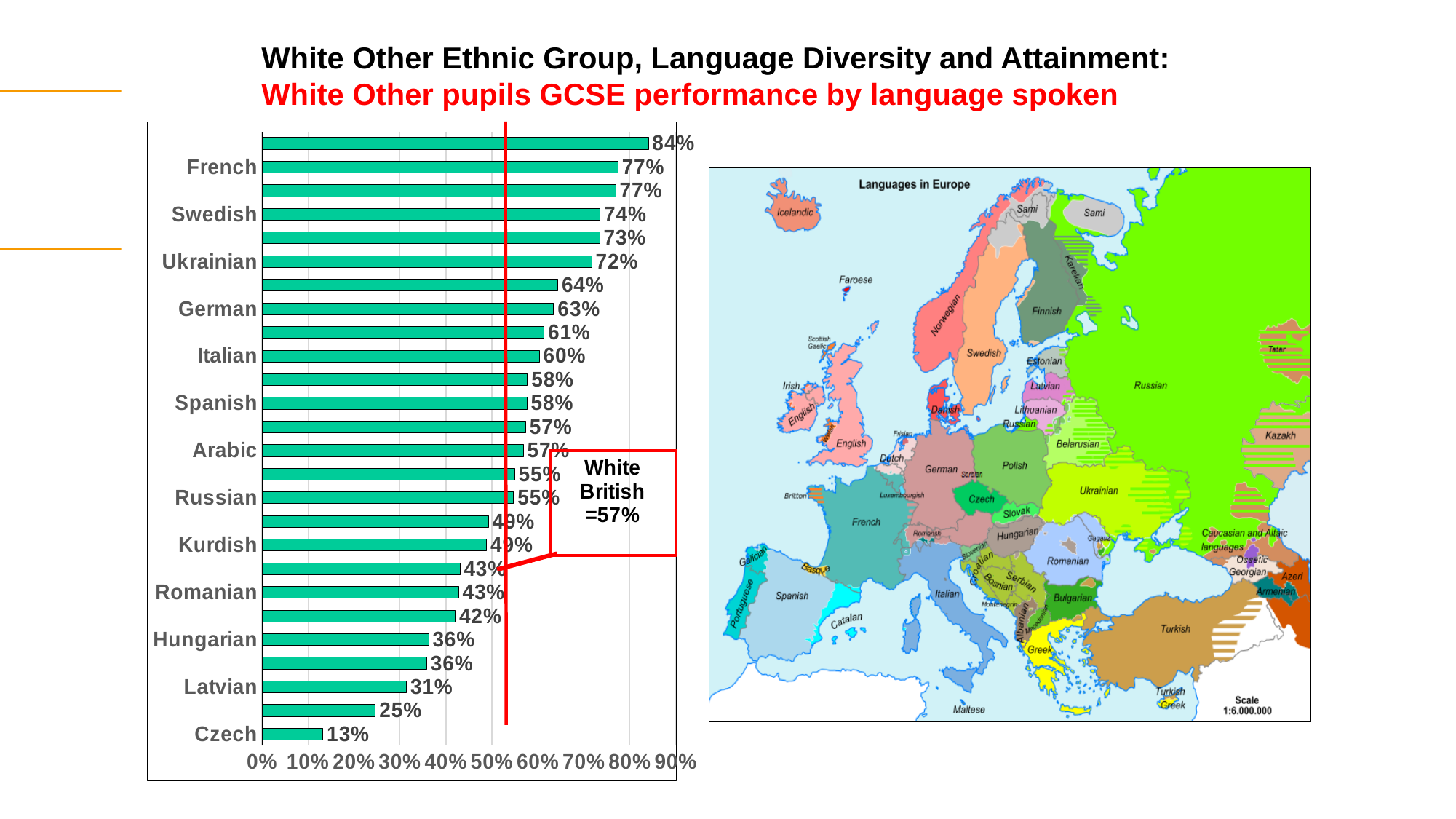
What is the difference between the values for Swedish and Latvian speakers? 43 percentage points What is the value shown for German-speaking pupils? 63% Is the value for Ukrainian speakers greater or less than 70%? greater Which has the higher value, Italian or Spanish speakers? Italian What is the difference between the values for Arabic and Russian speakers? 2 percentage points What is the value shown for Czech-speaking pupils? 13% What is the value shown for Romanian-speaking pupils? 43% What is the GCSE performance value shown for French-speaking pupils? 77% What kind of chart is used to show GCSE performance by language spoken? Bar chart Which labelled language group has the lowest GCSE performance value? Czech What is the value shown for Hungarian-speaking pupils? 36% What White British comparison value is marked by the red line on the chart? 57%